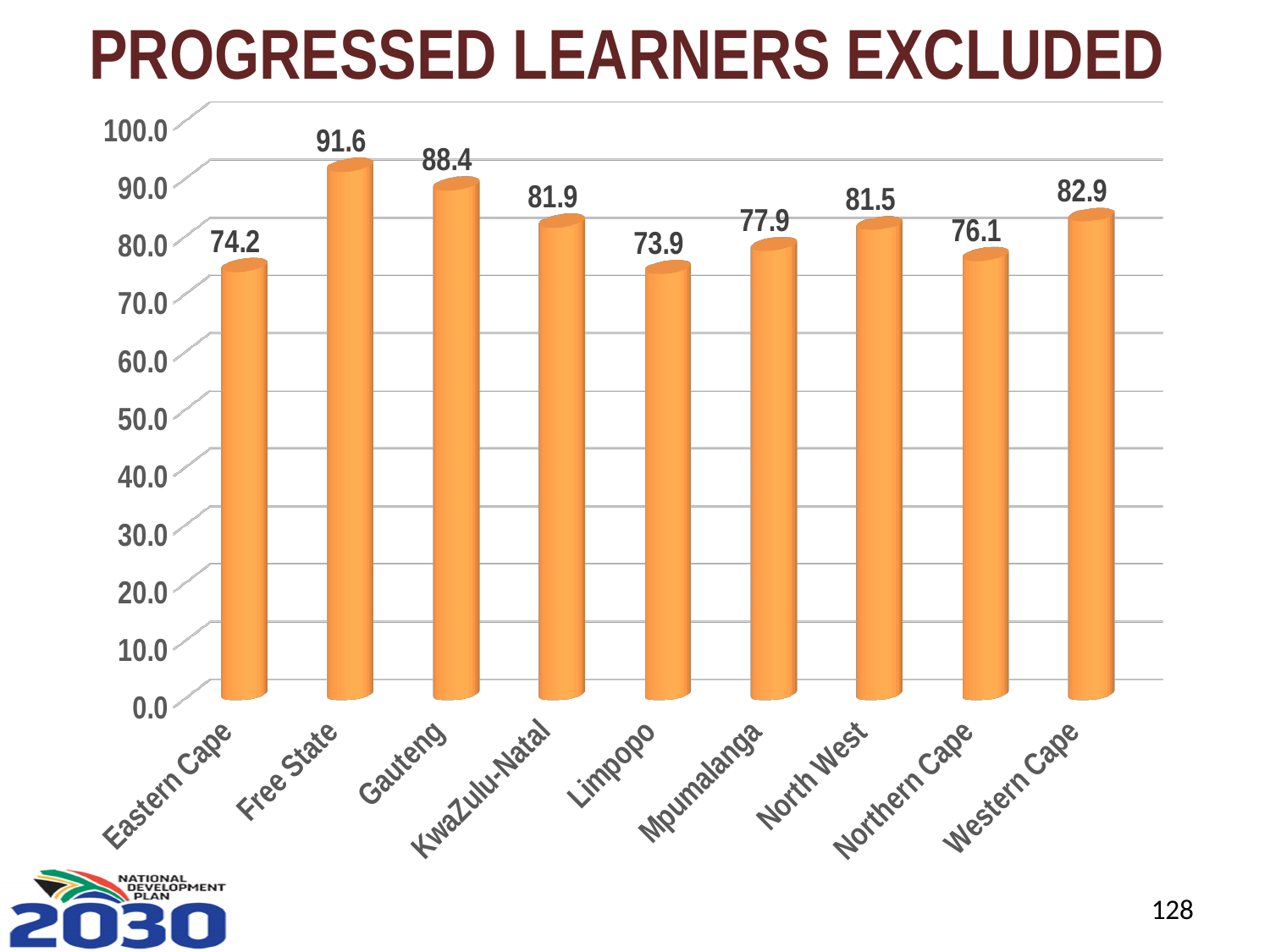
Which province has the highest value? Free State Which is larger, the value for KwaZulu-Natal or the value for Mpumalanga? KwaZulu-Natal Is the value for North West greater or less than 80.0? greater What is the value for Northern Cape? 76.1 What is the difference between the values for Free State and Gauteng? 3.2 What kind of chart is shown on the slide? bar chart What is the title of the chart? PROGRESSED LEARNERS EXCLUDED How many provinces are shown on the chart? 9 What is the value for Limpopo? 73.9 Which province has the lowest value? Limpopo What is the value for Free State? 91.6 What is the difference between the values for Western Cape and Eastern Cape? 8.7